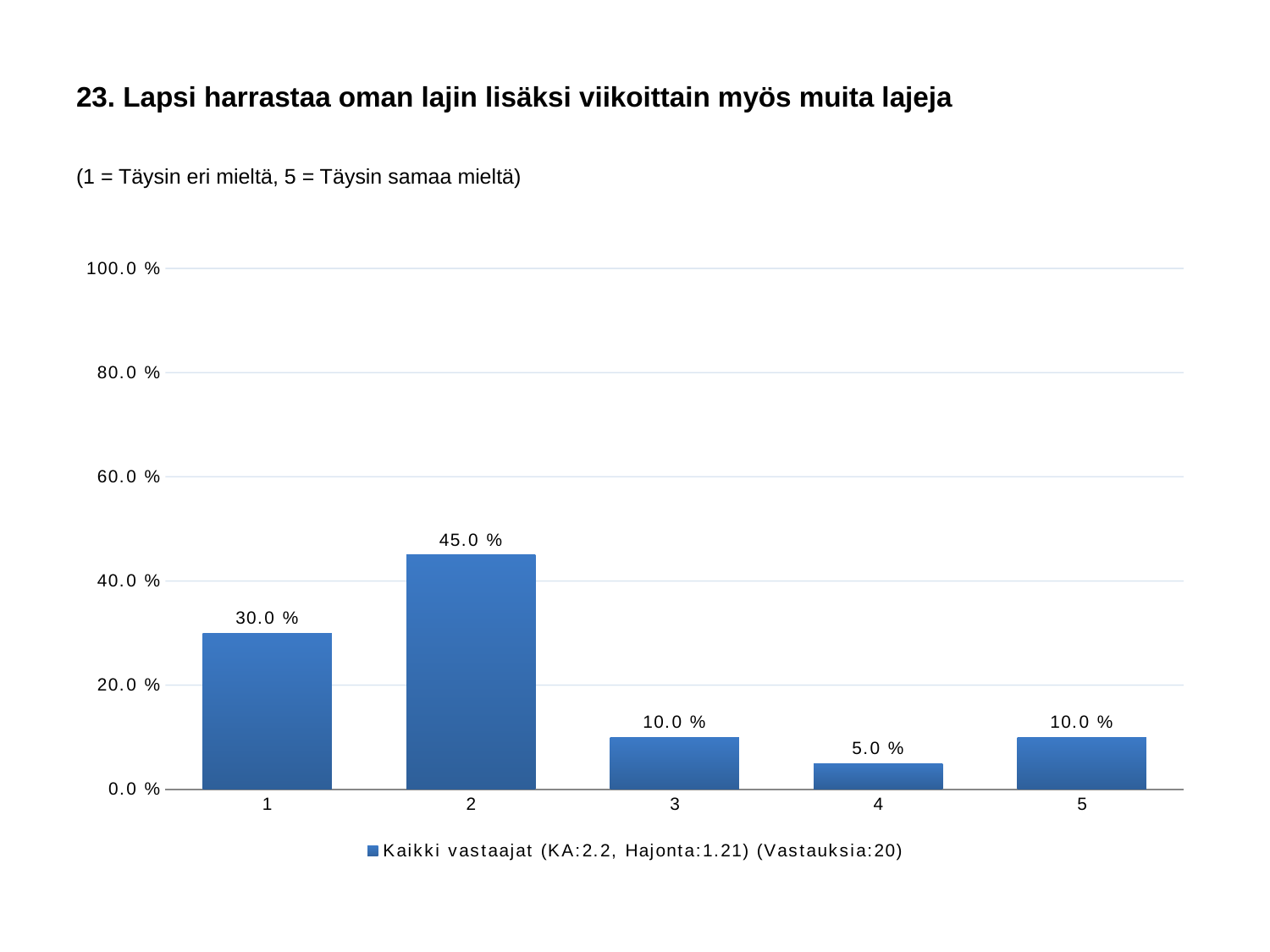
What is the value for category 1? 30.0 % What is the value for category 2? 45.0 % What is the value for category 4? 5.0 % Is the value for category 2 greater or less than 40.0 %? greater How many series does the legend list? 1 How many categories are shown on the x axis? 5 Which is larger, the value for category 1 or the value for category 3? 1 Which category has the lowest value? 4 Which category has the highest value? 2 What kind of chart is shown on the slide? bar chart What is the difference between the values for category 2 and category 1? 15.0 % What is the legend entry for the series? Kaikki vastaajat (KA:2.2, Hajonta:1.21) (Vastauksia:20)